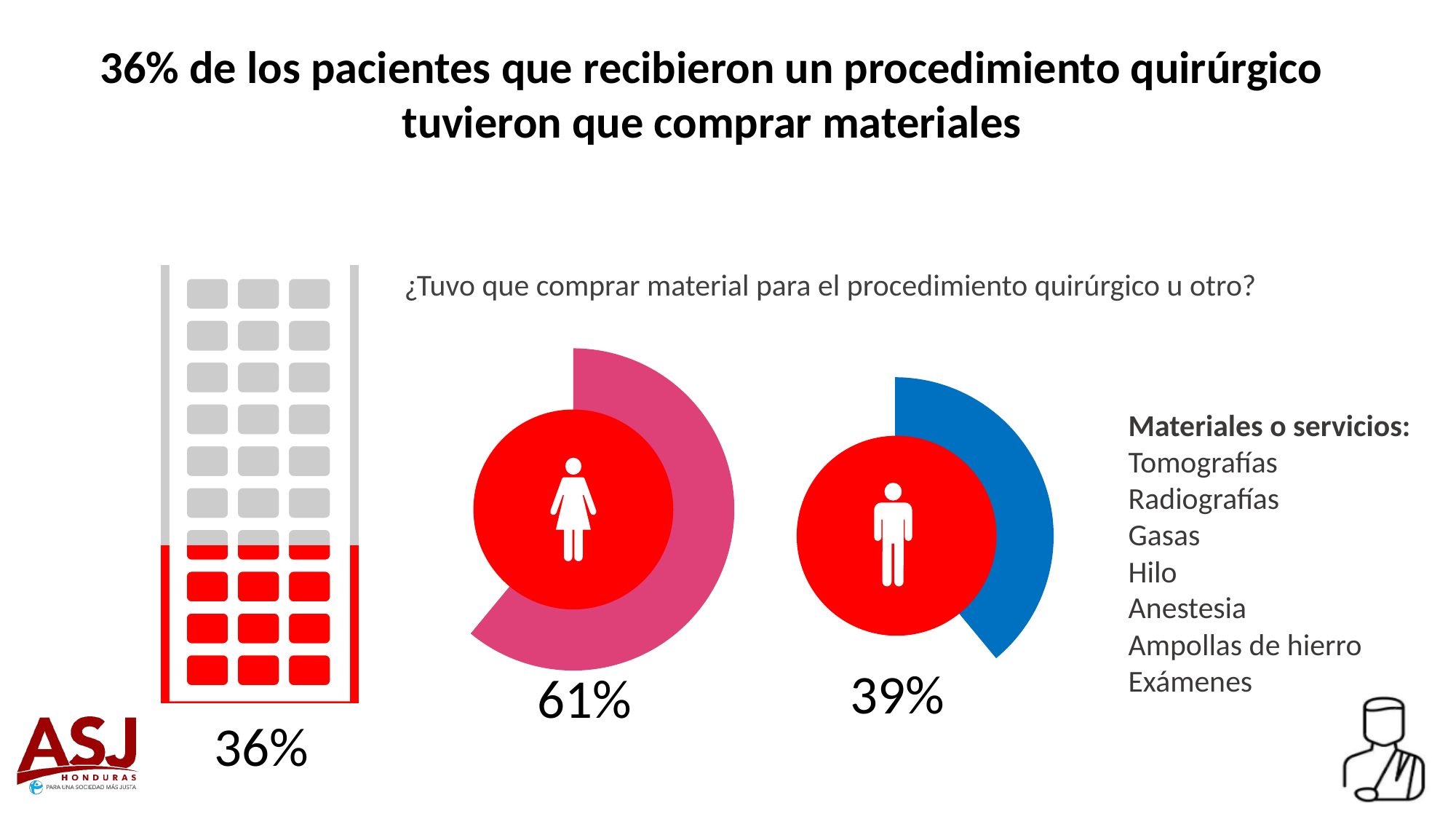
What colour is the ring around the female figure in the middle of the slide? Pink In the ring charts in the middle of the slide, is the value for the male figure greater or less than 50%? less What percentage is shown below the red-and-grey grid chart on the left of the slide? 36% What question is written above the ring charts in the middle of the slide? ¿Tuvo que comprar material para el procedimiento quirúrgico u otro? In the ring charts in the middle of the slide, what is the difference between the female percentage and the male percentage? 22 percentage points In the ring charts in the middle of the slide, which figure has the larger percentage, the female or the male? Female (61%) In the ring charts in the middle of the slide, what do the female and male percentages add up to? 100% In the ring charts in the middle of the slide, what percentage is shown for the female figure? 61% How many columns of squares does the grid chart on the left of the slide have? 3 How many red squares are filled in the grid chart on the left of the slide? 12 In the ring charts in the middle of the slide, what percentage is shown for the male figure? 39% In the ring charts in the middle of the slide, is the value for the female figure greater or less than 50%? greater